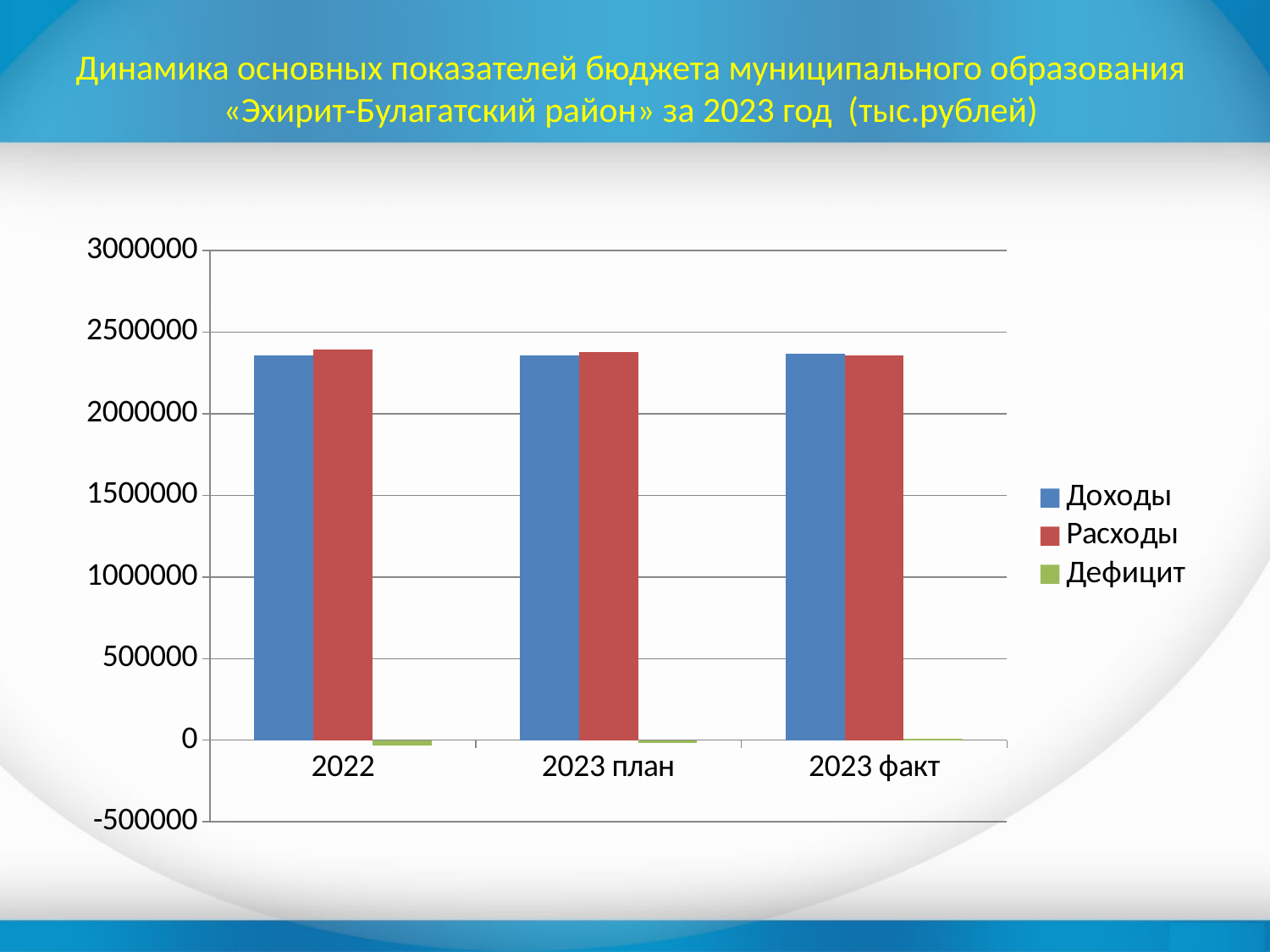
Which series has the highest value in the 2022 category? Расходы Is the value for Расходы in 2022 greater or less than 2500000? less Is the value for Доходы in 2022 greater or less than 2000000? greater Is the value for Дефицит in 2022 greater or less than 500000? less How many categories are shown on the x axis? 3 How many series does the legend list? 3 Which series has the lowest value in the 2023 план category? Дефицит What colour represents the Дефицит series in the legend? green What kind of chart is shown on the slide? bar chart What are the three category labels on the x axis? 2022, 2023 план, 2023 факт In 2022, which is larger: Доходы or Расходы? Расходы